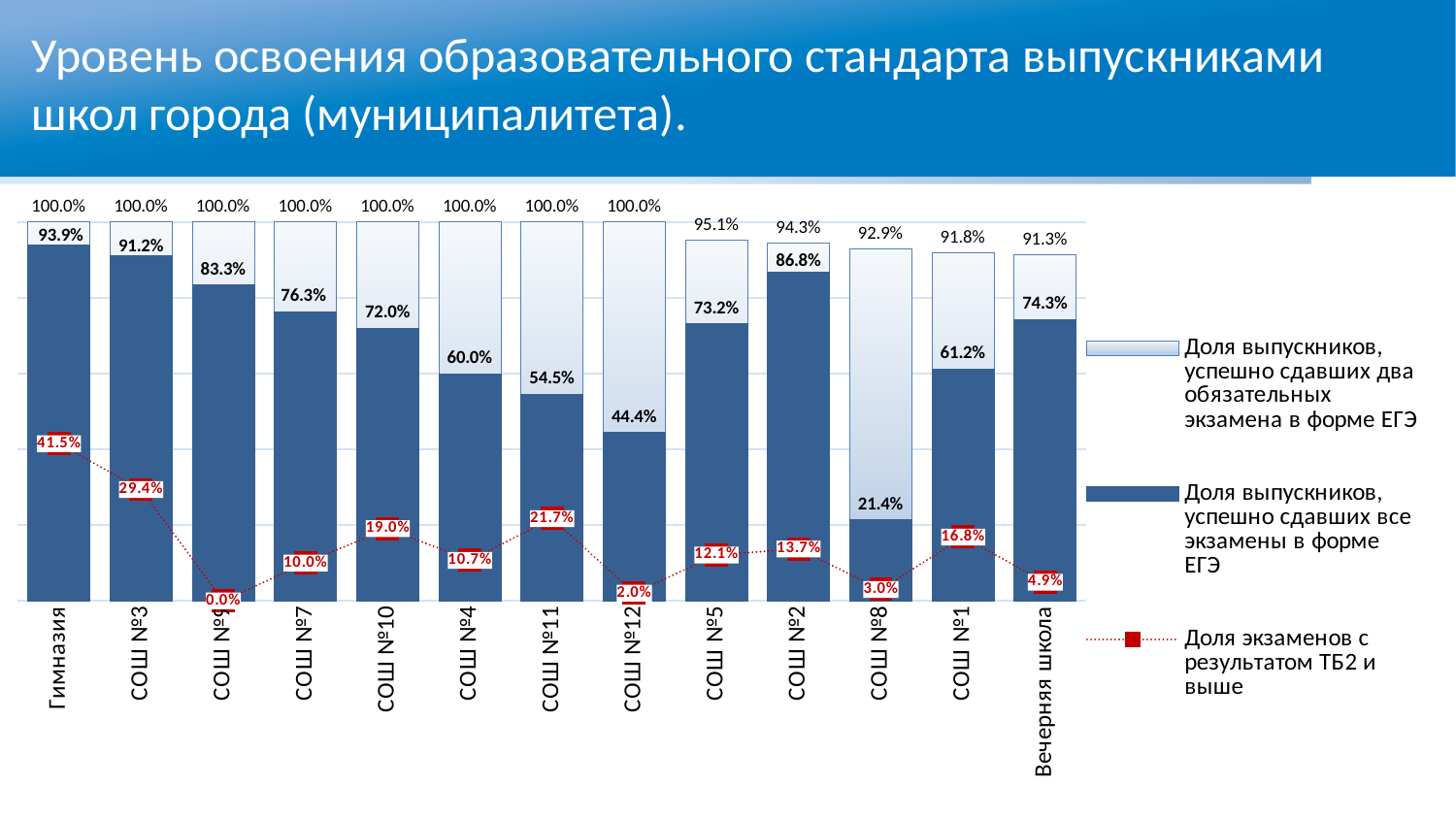
Which school has the highest share of graduates who successfully passed all exams in the form of ЕГЭ (dark blue bars)? Гимназия What kind of chart is shown on the slide? A combination bar and line chart What is the share of exams with a result of ТБ2 and above (red line) for Гимназия? 41.5% What is the value of the red line (share of exams with result ТБ2 and above) for СОШ №12? 2.0% Which school has a higher share of graduates who passed all exams in the form of ЕГЭ: СОШ №5 or СОШ №1? СОШ №5 For СОШ №2, what is the difference between the share passing the two mandatory exams (94.3%) and the share passing all exams (86.8%)? 7.5 percentage points What is the share of graduates who passed the two mandatory exams (light blue bar) for Вечерняя школа? 91.3% How many schools are shown on the x axis of the chart? 13 What is the share of graduates who successfully passed all exams in the form of ЕГЭ (dark blue bar) for СОШ №8? 21.4% How many series does the chart legend list? 3 What is the lowest value shown on the red line (share of exams with result ТБ2 and above)? 0.0% Which school has the lowest share of graduates who successfully passed all exams in the form of ЕГЭ (dark blue bars)? СОШ №8